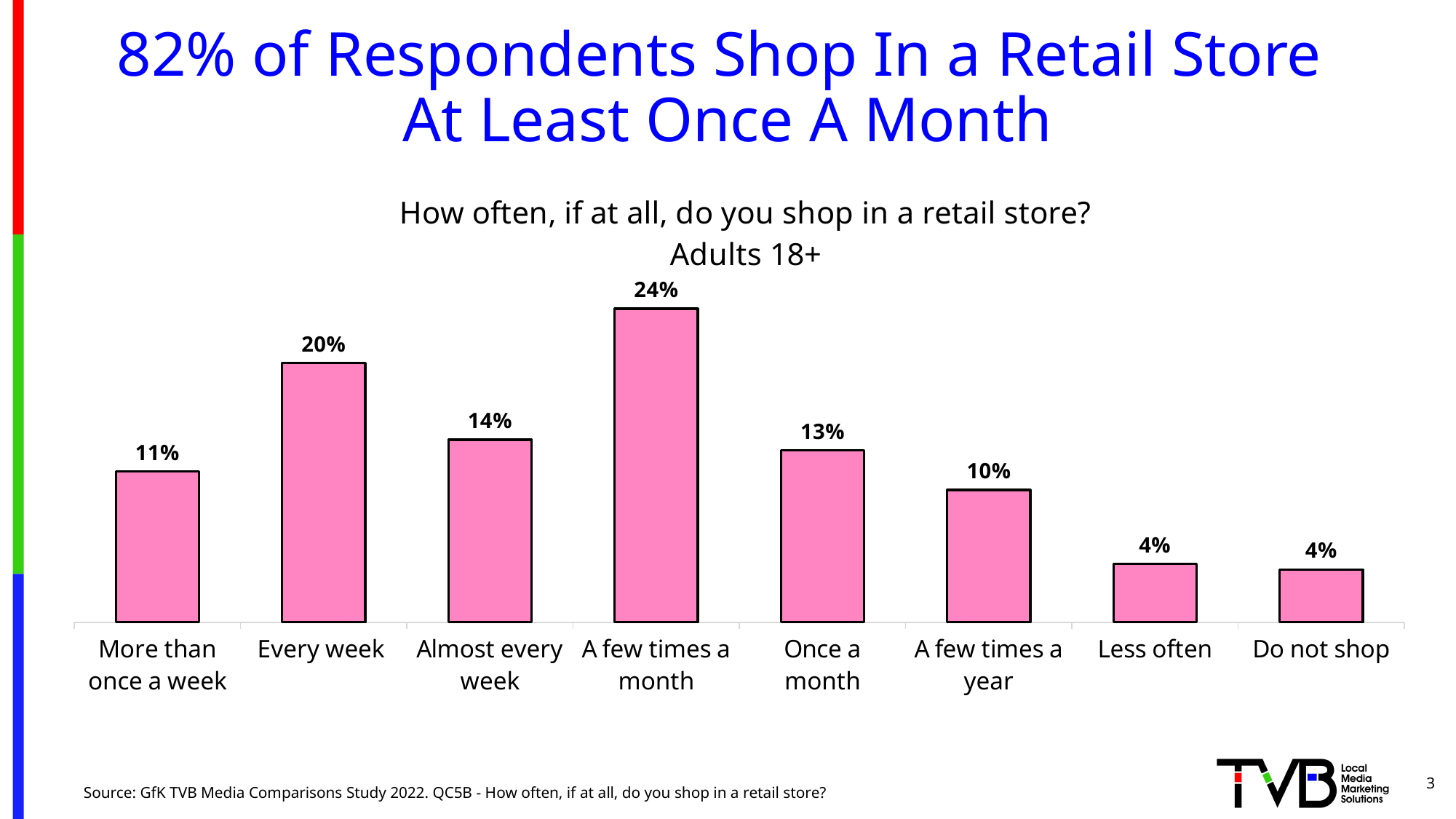
What is the difference in percentage points between 'A few times a month' and 'Once a month'? 11 What percentage of respondents shop in a retail store once a month? 13% What percentage of respondents shop in a retail store every week? 20% What audience group does the chart subtitle say the data covers? Adults 18+ Which is larger: the value for 'Almost every week' or the value for 'A few times a year'? Almost every week What is the combined percentage for 'Less often' and 'Do not shop'? 8% What is the difference in percentage points between 'Every week' and 'More than once a week'? 9 Which shopping frequency category has the highest percentage of respondents? A few times a month What percentage of respondents do not shop in a retail store? 4% What percentage of respondents shop in a retail store a few times a month? 24% What type of chart is shown on the slide? Bar chart How many shopping frequency categories are shown on the chart? 8